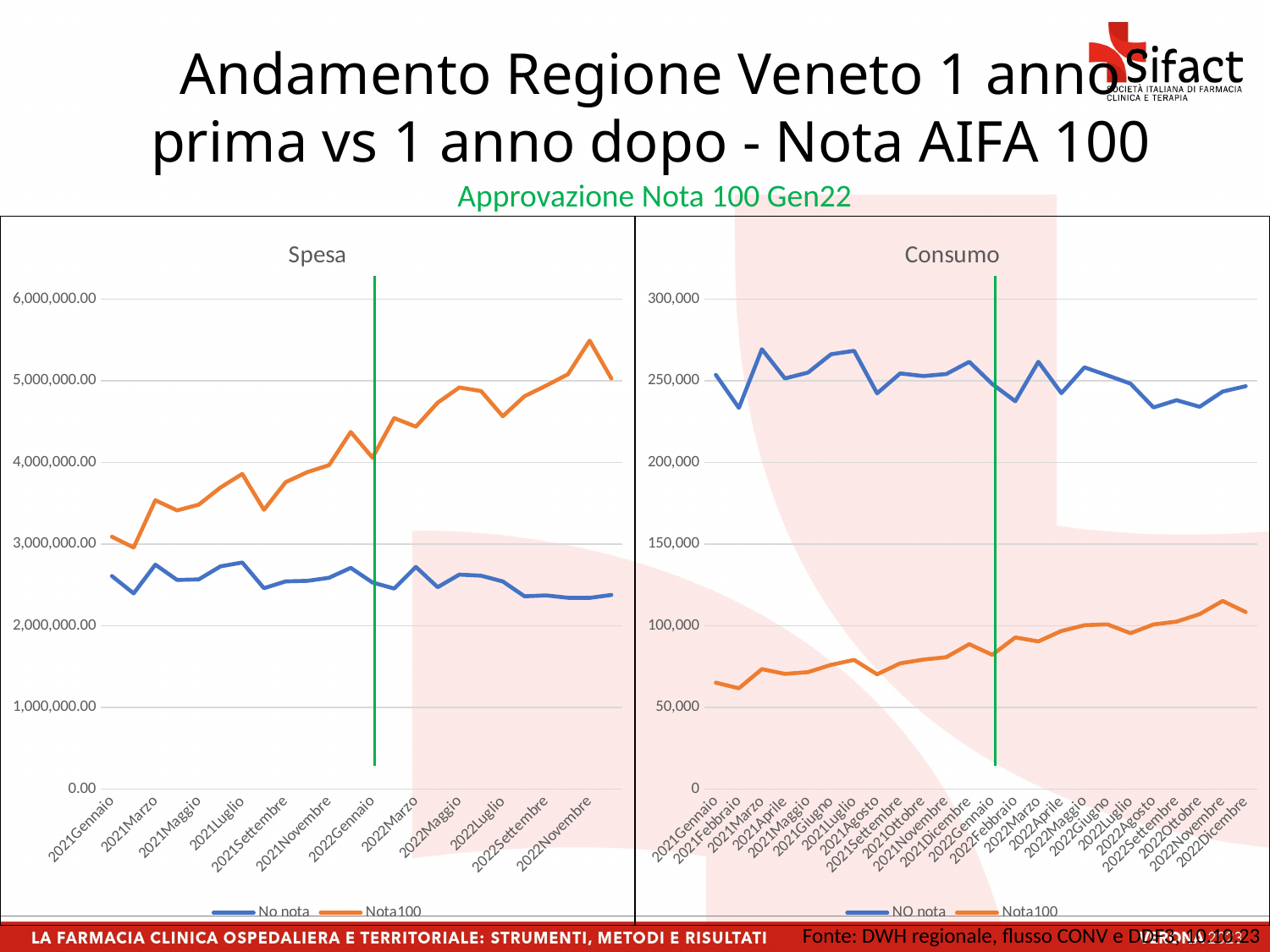
In the Consumo chart, at which month does the Nota100 series reach its highest value? 2022Novembre In the Spesa chart, is the value of Nota100 for 2022Novembre greater or less than 5,000,000.00? greater What kind of chart is the Spesa chart? line chart In the Spesa chart, which series has the higher value at 2022Novembre, No nota or Nota100? Nota100 In the Consumo chart, is the value of NO nota for 2021Gennaio greater or less than 200,000? greater How many series does the legend of the Consumo chart list? 2 What is the title of the left chart? Spesa In the Spesa chart, does the Nota100 series generally rise or fall from 2021Gennaio to 2022Novembre? rise In the Consumo chart, is the value of Nota100 for 2022Dicembre greater or less than 100,000? greater In the Consumo chart, which series has the higher value at 2022Dicembre, NO nota or Nota100? NO nota How many months are plotted on the x axis of the Consumo chart? 24